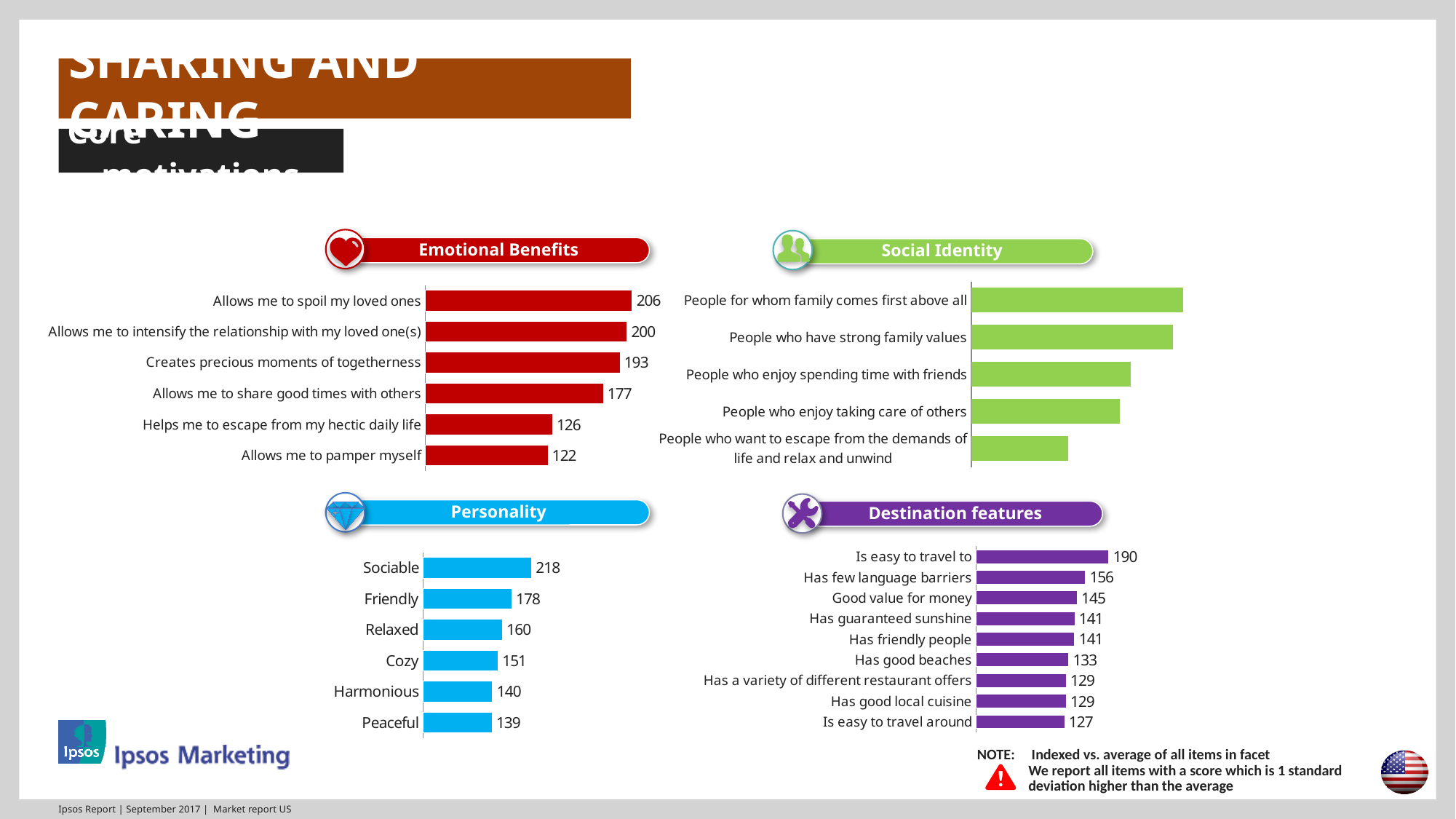
In the Emotional Benefits chart, which category has the lowest value? Allows me to pamper myself In the Social Identity chart, which category has the highest value? People for whom family comes first above all In the Personality chart, what is the value for "Cozy"? 151 In the Destination features chart, what is the value for "Has few language barriers"? 156 In the Emotional Benefits chart, what is the difference between "Allows me to share good times with others" and "Helps me to escape from my hectic daily life"? 51 In the Social Identity chart, which is larger: "People who enjoy spending time with friends" or "People who want to escape from the demands of life and relax and unwind"? People who enjoy spending time with friends In the Emotional Benefits chart, what is the value for "Allows me to spoil my loved ones"? 206 How many categories are shown in the Destination features chart? 9 In the Personality chart, what is the difference between "Sociable" and "Peaceful"? 79 How many categories are shown in the Social Identity chart? 5 In the Personality chart, which category has the highest value? Sociable What type of chart is the Destination features chart? Bar chart